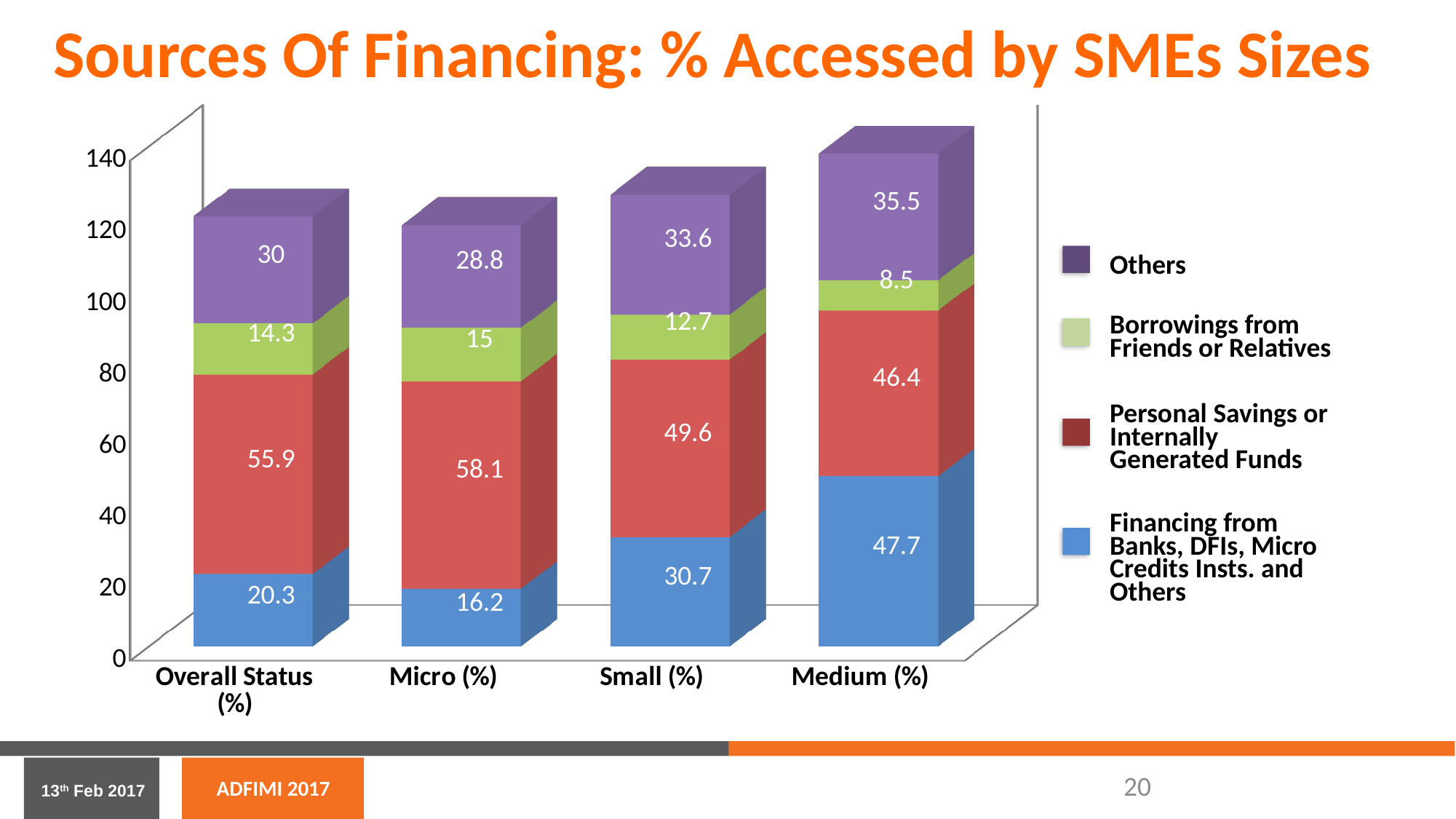
What is the value for Financing from Banks, DFIs, Micro Credits Insts. and Others in the Medium (%) category? 47.7 How many series does the legend list? 4 What is the total of the stacked bar for Medium (%)? 138.1 Which category has the highest value for Financing from Banks, DFIs, Micro Credits Insts. and Others? Medium (%) Which is larger: the Others value for Small (%) or for Micro (%)? Small (%) What is the value for Personal Savings or Internally Generated Funds in the Micro (%) category? 58.1 How many categories are shown on the x axis? 4 What is the value for Others in the Overall Status (%) category? 30 What kind of chart is shown on the slide? Stacked bar chart What is the difference between the Personal Savings or Internally Generated Funds values for Micro (%) and Medium (%)? 11.7 What is the value for Borrowings from Friends or Relatives in the Small (%) category? 12.7 Which category has the lowest value for Borrowings from Friends or Relatives? Medium (%)